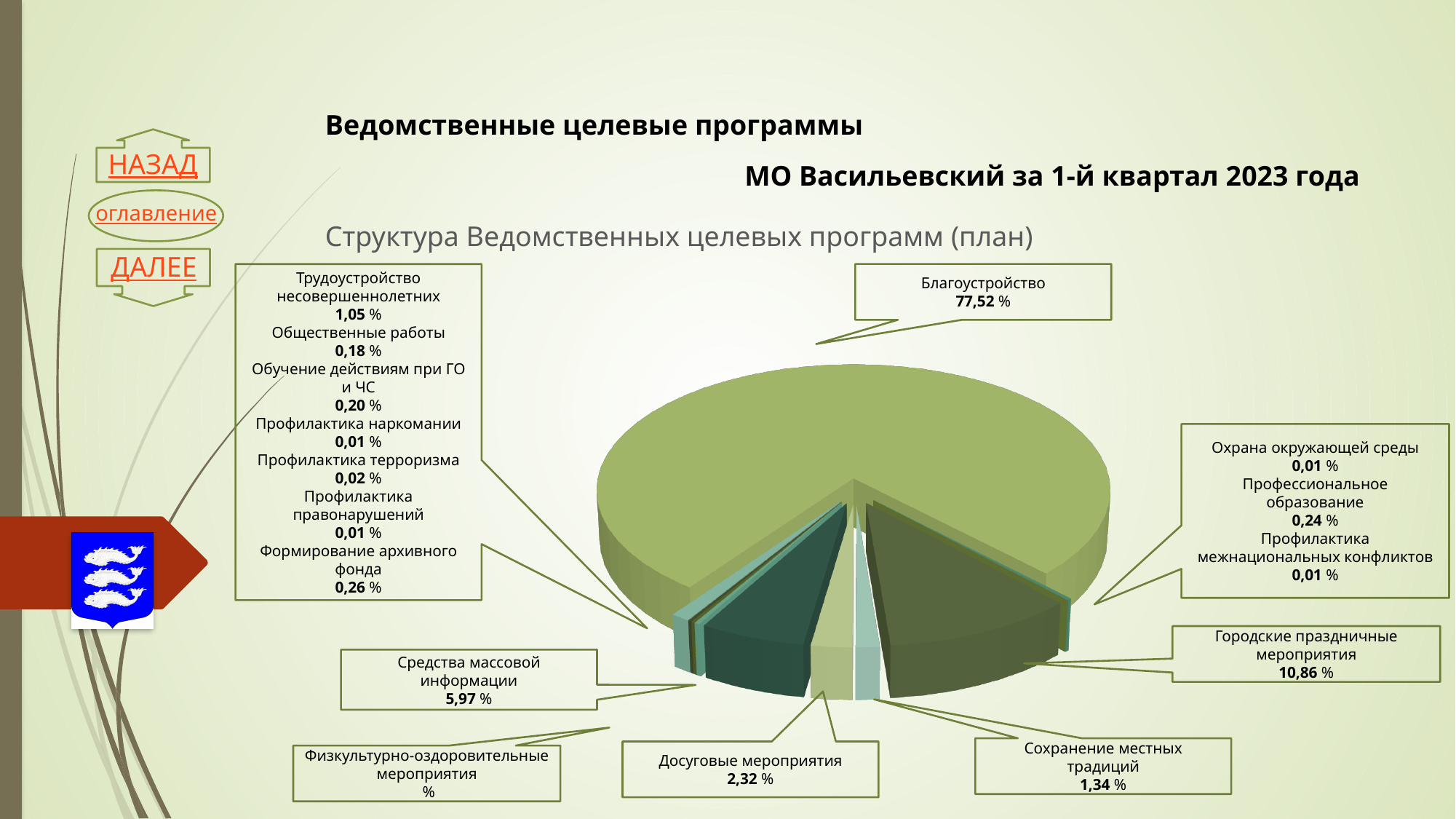
What is the difference between the shares of Благоустройство and Городские праздничные мероприятия? 66,66 % What is the title of the chart? Структура Ведомственных целевых программ (план) What is the value for Досуговые мероприятия? 2,32 % What percentage is listed for Профессиональное образование? 0,24 % What type of chart is shown on the slide? Pie chart What is the value shown for Городские праздничные мероприятия? 10,86 % What percentage is given for Сохранение местных традиций? 1,34 % What percentage is shown for Средства массовой информации? 5,97 % Which category has the largest share of the pie? Благоустройство What is the value shown for Трудоустройство несовершеннолетних? 1,05 % What share of the pie does Благоустройство account for? 77,52 % Which is larger, Досуговые мероприятия or Сохранение местных традиций? Досуговые мероприятия